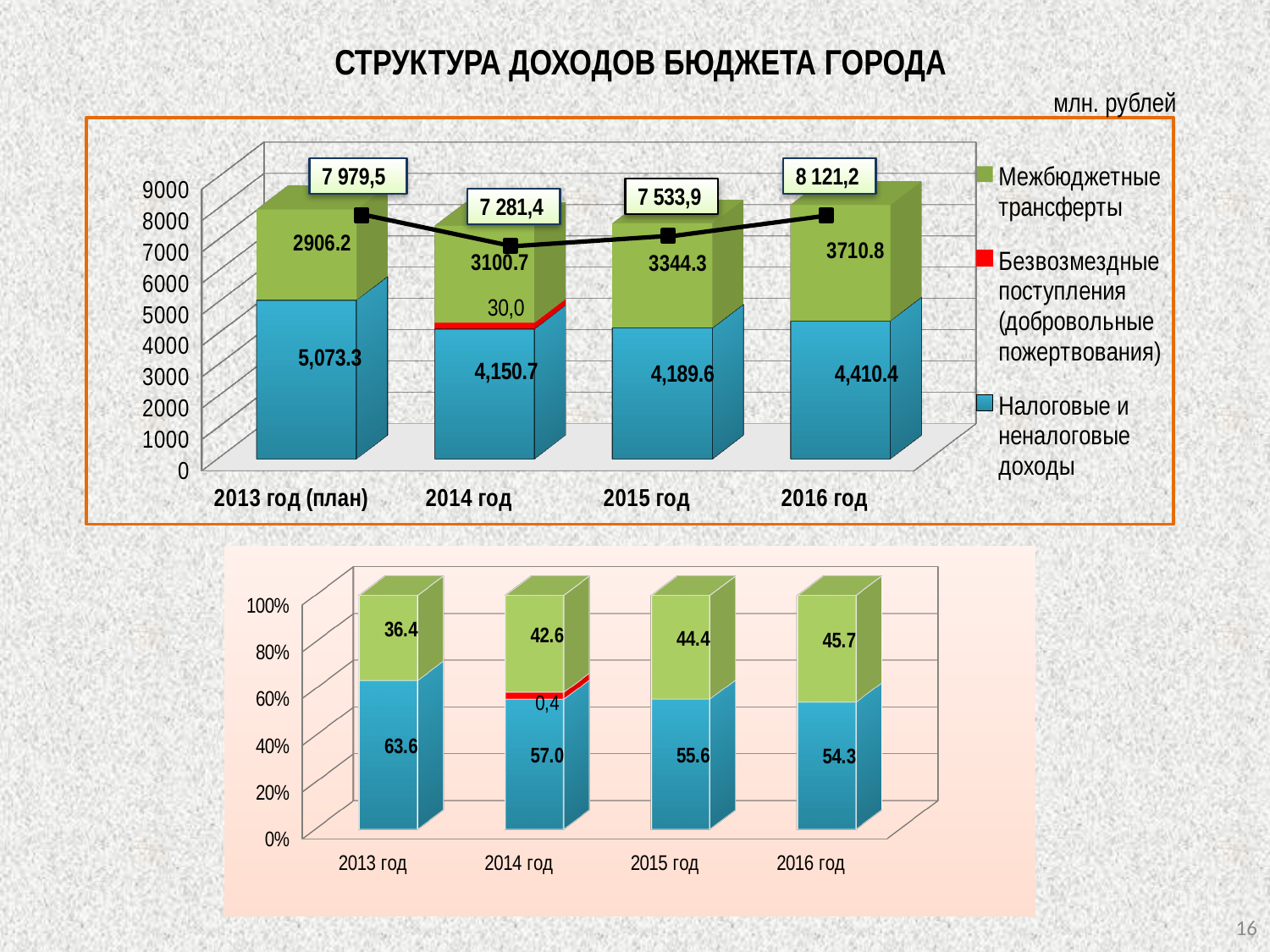
In the top chart, what is the value of Налоговые и неналоговые доходы for 2013 год (план)? 5,073.3 In the bottom chart, does the blue segment's share rise or fall from 2013 год to 2016 год? fall In the top chart, which year has the highest total shown on the line? 2016 год In the top chart, what is the difference between Налоговые и неналоговые доходы in 2016 год and 2015 год? 220.8 In the top chart, what total is shown by the line label for 2014 год? 7 281,4 In the top chart, what is the value of Межбюджетные трансферты for 2016 год? 3710.8 In the top chart, what is the value of Безвозмездные поступления for 2014 год? 30,0 In the top chart, which year has the lowest value of Межбюджетные трансферты? 2013 год (план) In the top chart, how many series does the legend list? 3 What kind of chart is the bottom chart? stacked bar chart In the bottom chart, which year has the highest share for the blue segment? 2013 год In the bottom chart, what share does the green segment have for 2015 год? 44.4